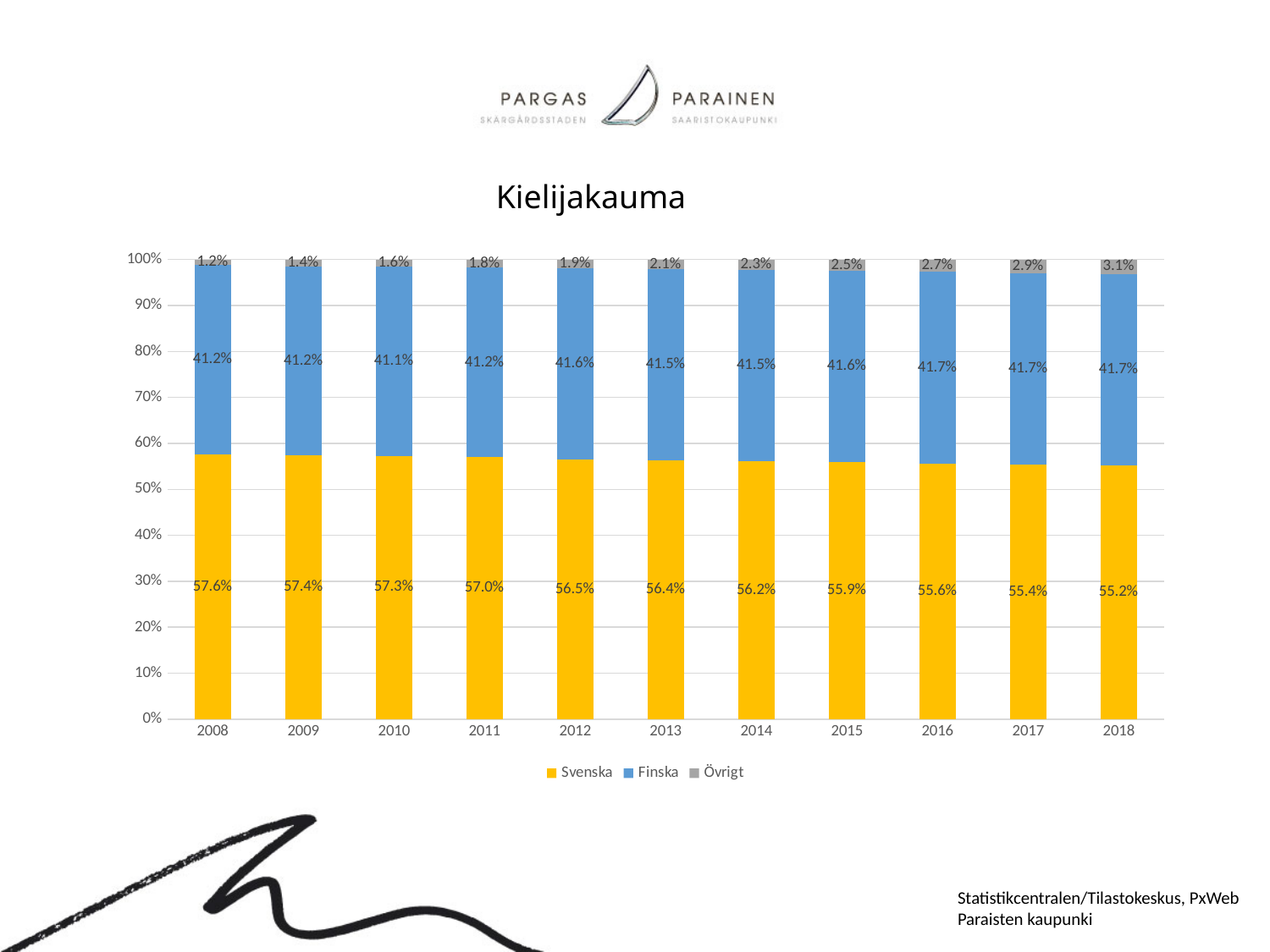
What kind of chart is shown? Stacked bar chart What is the value for Finska in 2018? 41.7% What is the value for Övrigt in 2013? 2.1% How many years are shown on the x axis? 11 In which year is the Övrigt share lowest? 2008 How many series does the legend list? 3 Does the Övrigt share rise or fall from 2008 to 2018? Rise Which is larger in 2015, the Svenska share or the Finska share? Svenska What is the value for Svenska in 2008? 57.6% In which year is the Svenska share highest? 2008 What is the title of the chart? Kielijakauma What is the difference between the Svenska share in 2008 and in 2018? 2.4%